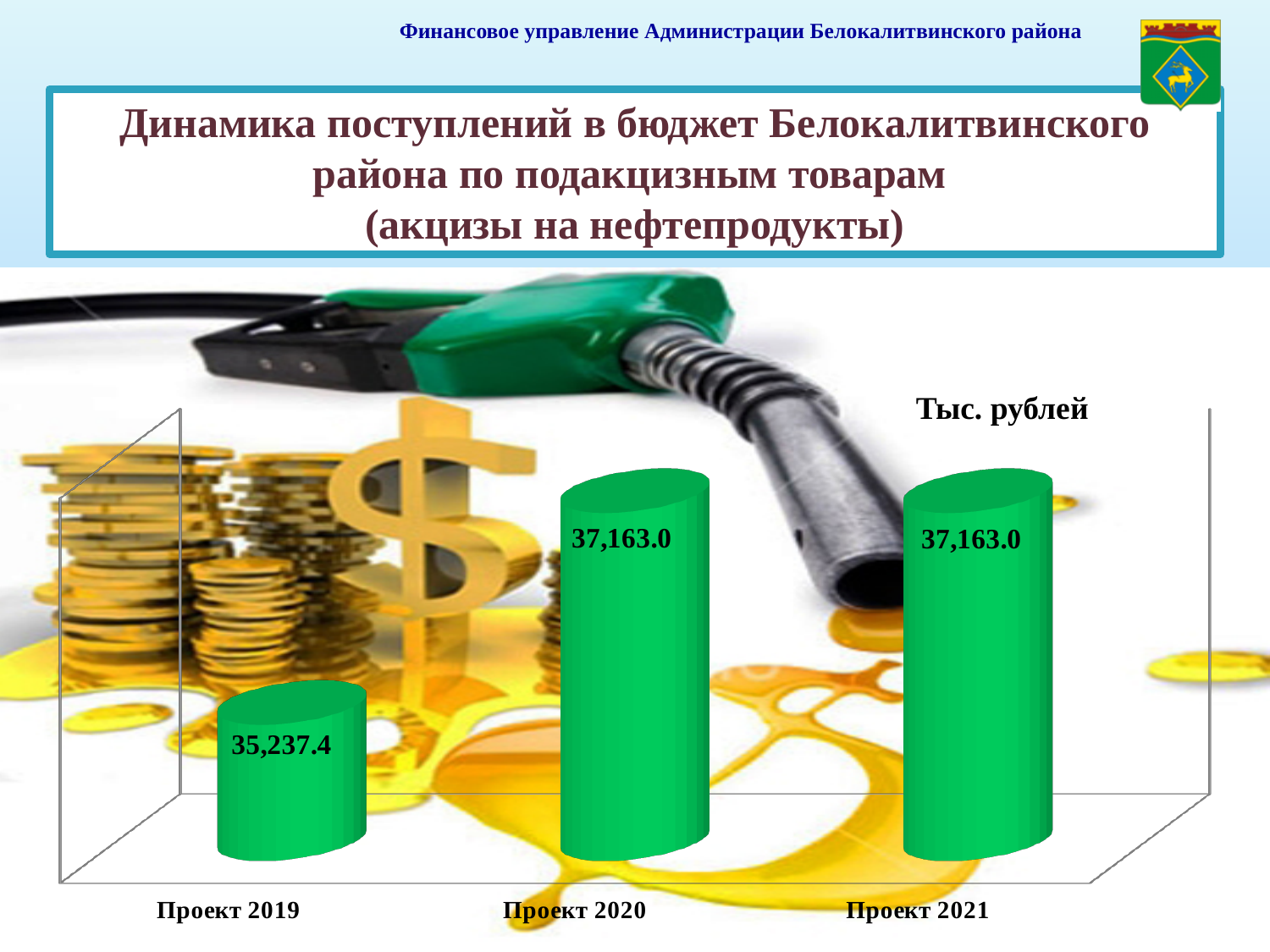
What is the value for Проект 2020? 37,163.0 How many categories are shown on the chart? 3 What kind of chart is shown on the slide? bar chart What colour are the bars on the chart? green What is the value for Проект 2019? 35,237.4 Which is larger, the value for Проект 2019 or Проект 2020? Проект 2020 In what units are the chart values given? Тыс. рублей What is the difference between the values for Проект 2020 and Проект 2019? 1,925.6 Does the value rise or fall from Проект 2019 to Проект 2020? rise Which category has the lowest value? Проект 2019 Are the values for Проект 2020 and Проект 2021 the same or different? the same What is the value for Проект 2021? 37,163.0